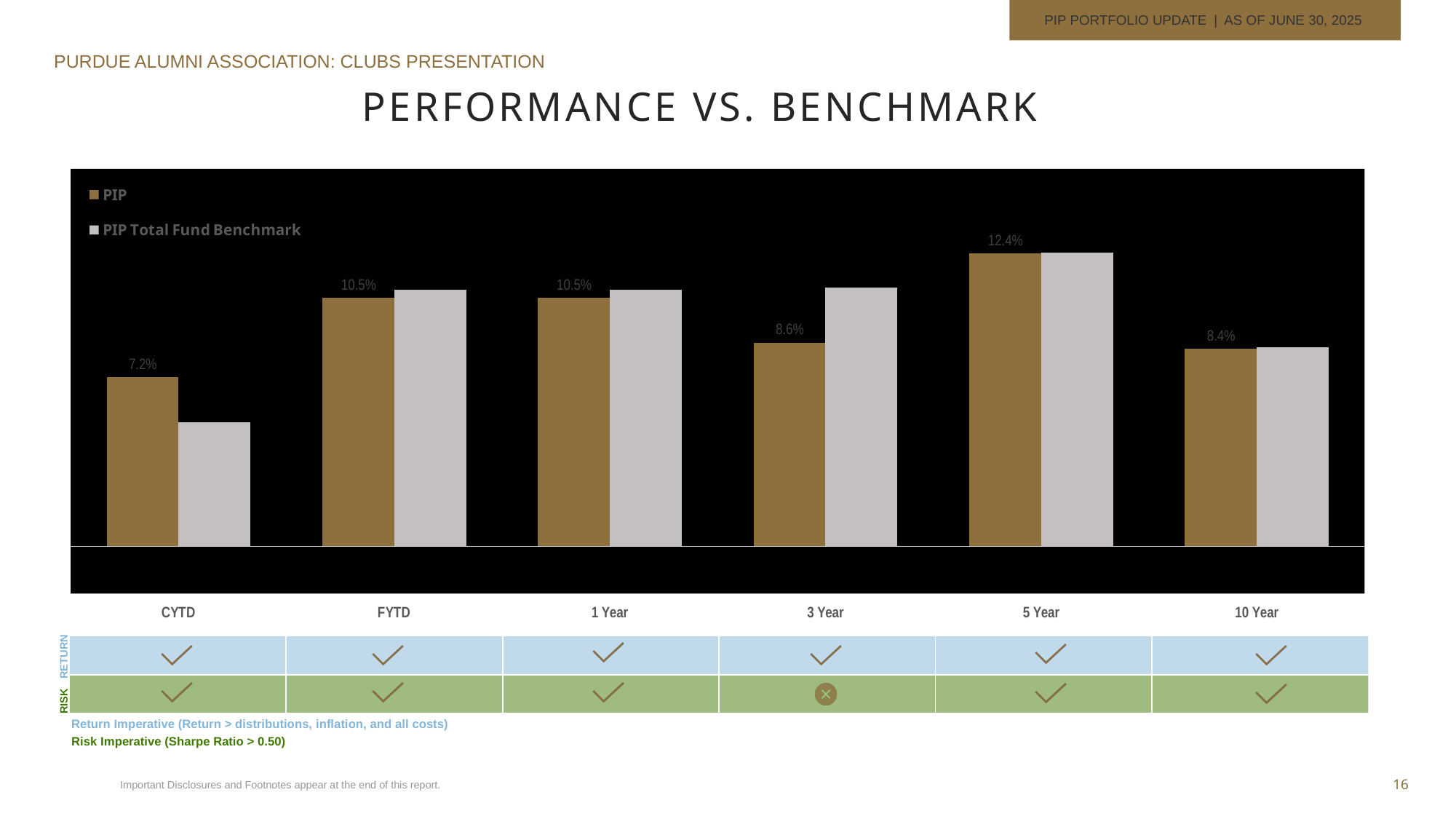
What is the difference between the PIP value for 5 Year and the PIP value for CYTD? 5.2 percentage points What is the PIP value for CYTD? 7.2% What is the PIP value for 3 Year? 8.6% Which period has the lowest PIP value? CYTD For 3 Year, which is larger: PIP or PIP Total Fund Benchmark? PIP Total Fund Benchmark For CYTD, which is larger: PIP or PIP Total Fund Benchmark? PIP How many periods are shown on the x axis of the chart? 6 What is the PIP value for 5 Year? 12.4% What type of chart is shown on the slide? Bar chart Which period has the highest PIP value? 5 Year What is the PIP value for 10 Year? 8.4% How many series does the chart legend list? 2